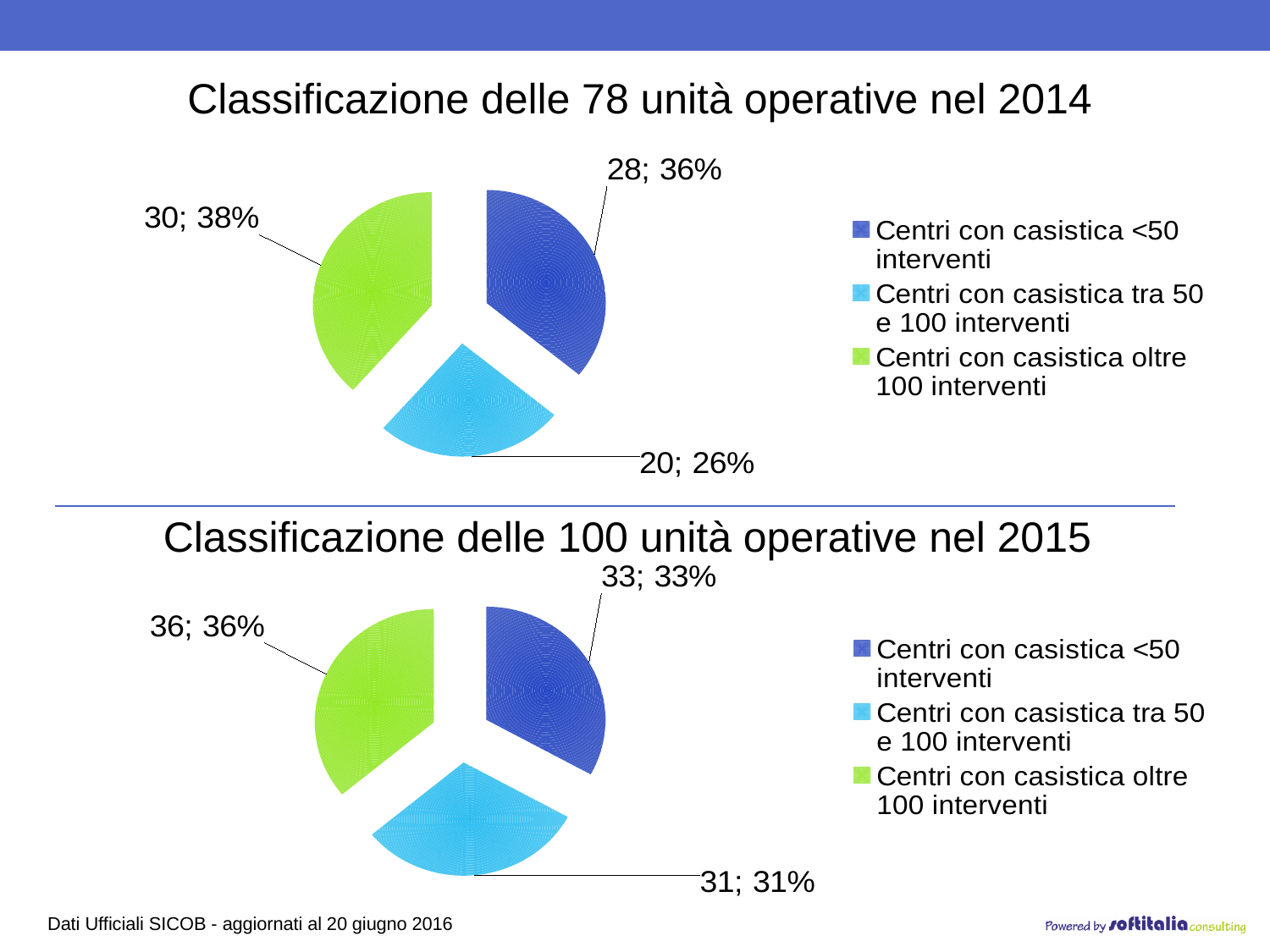
In the 2015 chart (bottom), how many units are 'Centri con casistica tra 50 e 100 interventi'? 31 In the 2014 chart (top), which category has the largest slice? Centri con casistica oltre 100 interventi In the 2015 chart (bottom), what share of the pie is 'Centri con casistica <50 interventi'? 33% What type of chart is used on this slide? Pie chart In the 2014 chart (top), what is the difference in units between 'Centri con casistica oltre 100 interventi' and 'Centri con casistica tra 50 e 100 interventi'? 10 What is the title of the top chart? Classificazione delle 78 unità operative nel 2014 In the 2014 chart (top), which category has the smallest slice? Centri con casistica tra 50 e 100 interventi In the 2015 chart (bottom), which is larger: 'Centri con casistica <50 interventi' or 'Centri con casistica tra 50 e 100 interventi'? Centri con casistica <50 interventi In the 2014 chart (top), what share of the pie is 'Centri con casistica oltre 100 interventi'? 38% In the 2015 chart (bottom), which category has the largest slice? Centri con casistica oltre 100 interventi How many categories does the legend of the 2015 chart (bottom) list? 3 In the 2014 chart (top), how many units are 'Centri con casistica <50 interventi'? 28